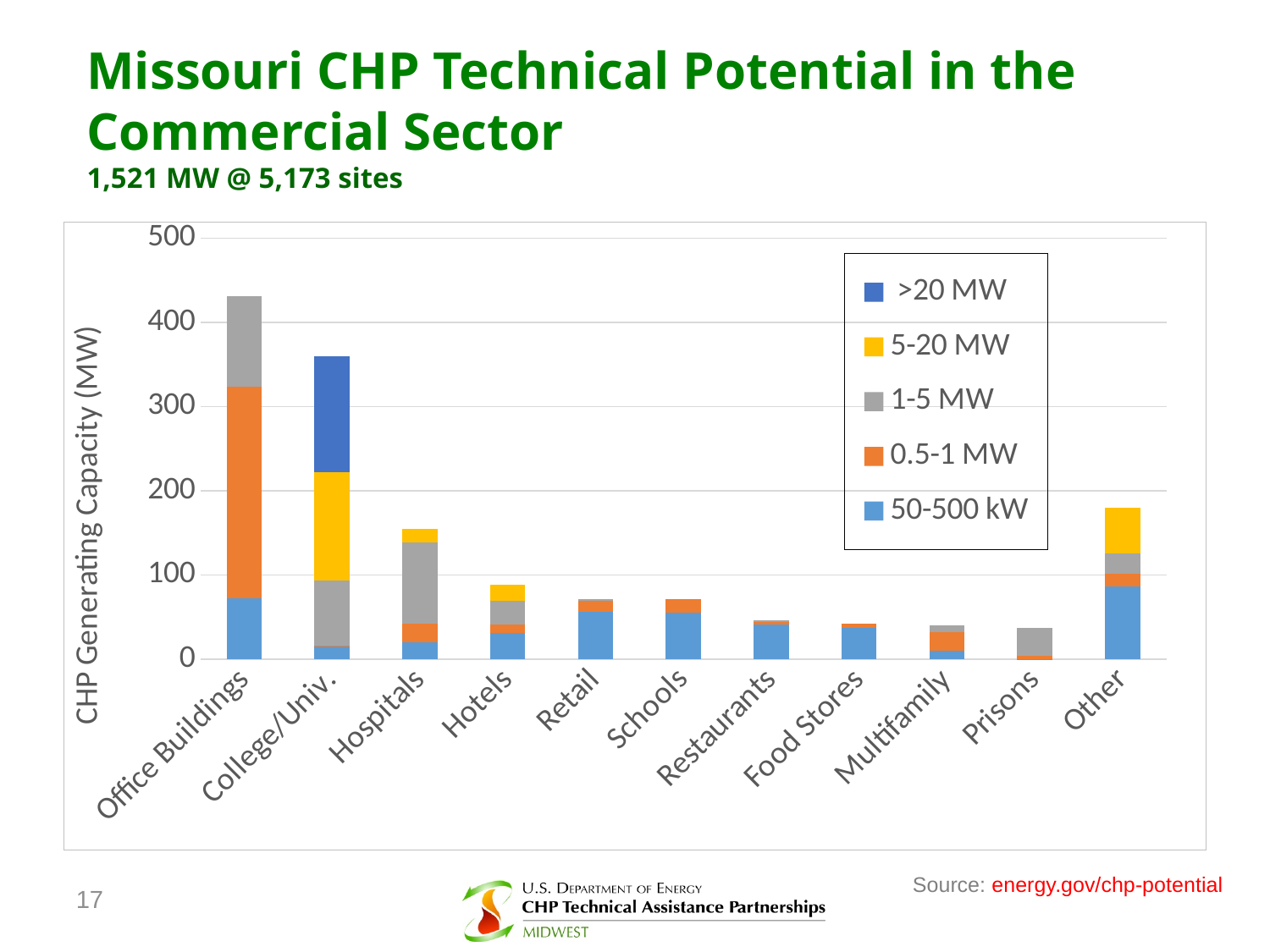
How many building categories are shown on the x axis of the chart? 11 Is the total value for Prisons greater or less than 100? less How many series does the chart's legend list? 5 Which has a larger total CHP generating capacity, Office Buildings or College/Univ.? Office Buildings Is the total value for Office Buildings greater or less than 400? greater Is the total value for Other greater or less than 200? less What is the label on the y axis of the chart? CHP Generating Capacity (MW) Which has a larger total CHP generating capacity, Hospitals or Hotels? Hospitals Which category has the highest total CHP generating capacity? Office Buildings What kind of chart is shown on the slide? stacked bar chart